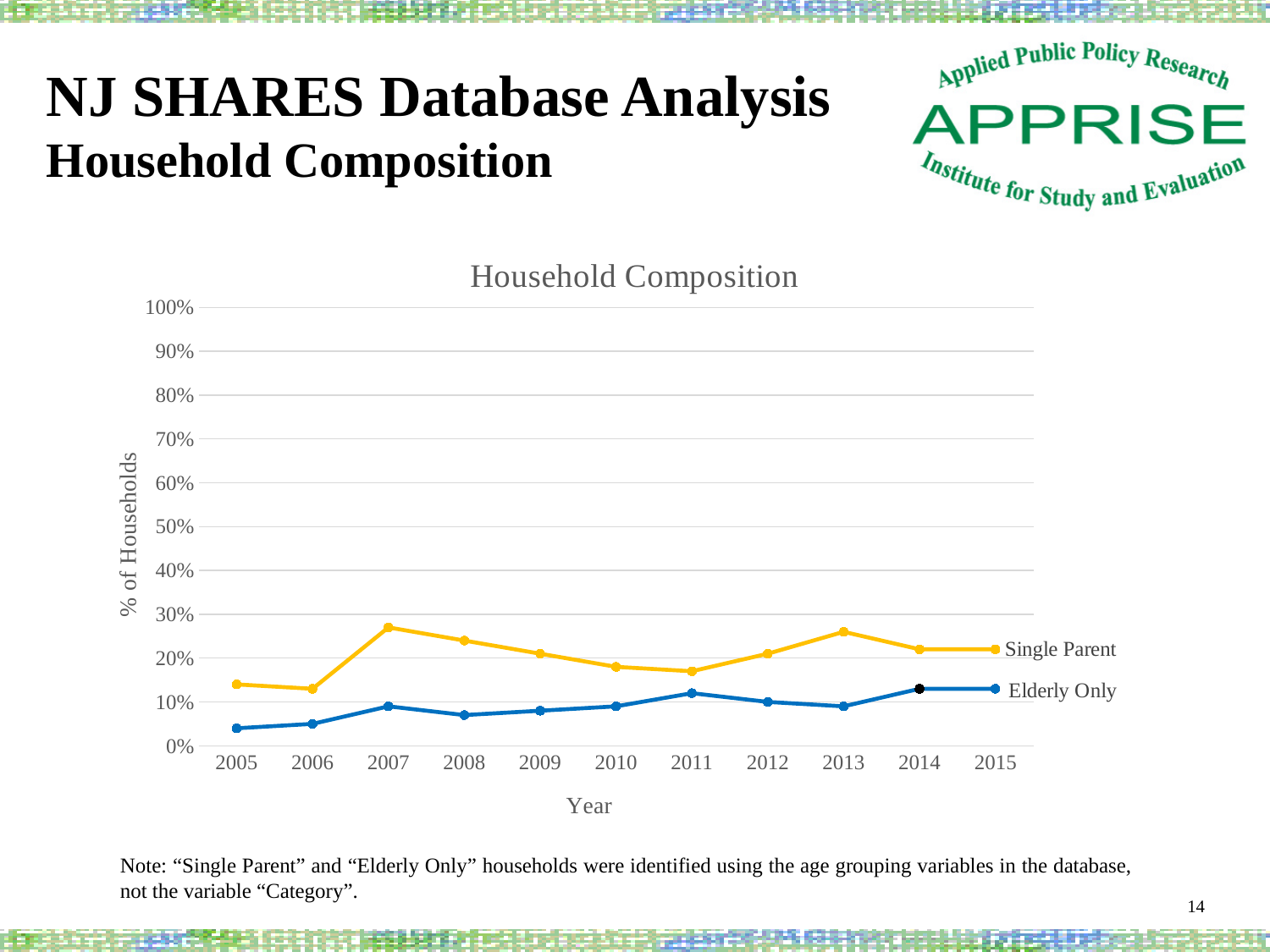
Does the Single Parent line rise or fall from 2007 to 2011? Fall How many series does the chart show? 2 Does the Elderly Only line generally rise or fall from 2005 to 2015? Rise Is the value for Single Parent in 2007 greater or less than 20%? greater Is the value for Elderly Only in 2005 greater or less than 10%? less What is the label on the vertical axis of the chart? % of Households Is the value for Elderly Only in 2011 greater or less than 10%? greater For Single Parent, which year has the higher value, 2007 or 2011? 2007 Which series has the higher value in 2007, Single Parent or Elderly Only? Single Parent How many years are plotted along the x axis? 11 What kind of chart is shown on the slide? Line chart